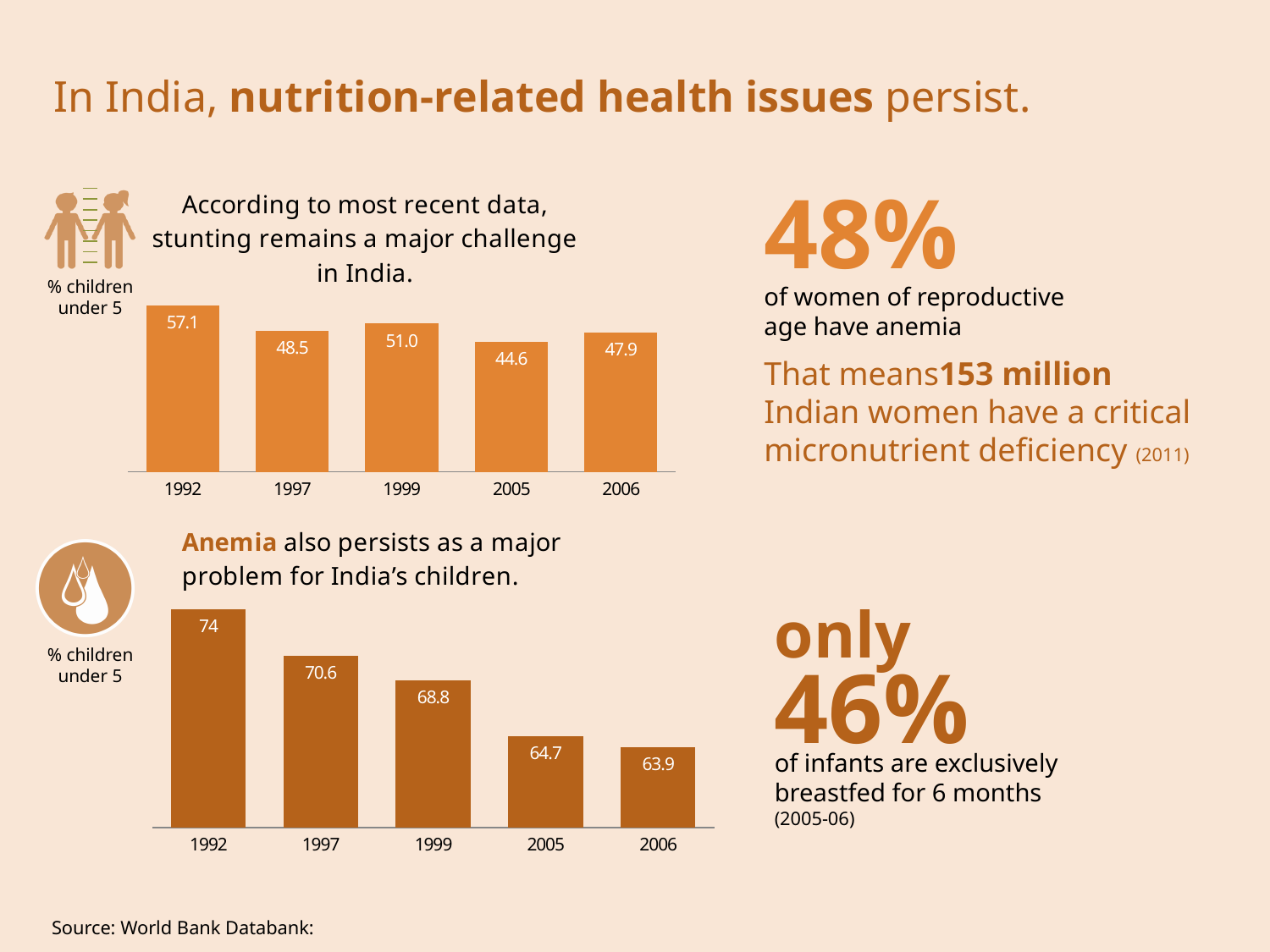
How many years are shown on the x axis of the anemia chart (bottom)? 5 In the stunting chart (top), what is the difference between the 1992 and 2006 values? 9.2 In the stunting chart (top), which is larger, the value for 1997 or the value for 1999? 1999 In the anemia chart (bottom), do the values rise or fall from 1992 to 2006? fall In the anemia chart (bottom), what is the value for 1999? 68.8 In the anemia chart (bottom), what is the difference between the 1992 and 1997 values? 3.4 In the stunting chart (top), what is the value for 1992? 57.1 In the stunting chart (top), which year has the highest value? 1992 In the stunting chart (top), which year has the lowest value? 2005 In the anemia chart (bottom), what is the value for 2006? 63.9 In the anemia chart (bottom), which year has the highest value? 1992 In the stunting chart (top), what is the value for 2005? 44.6